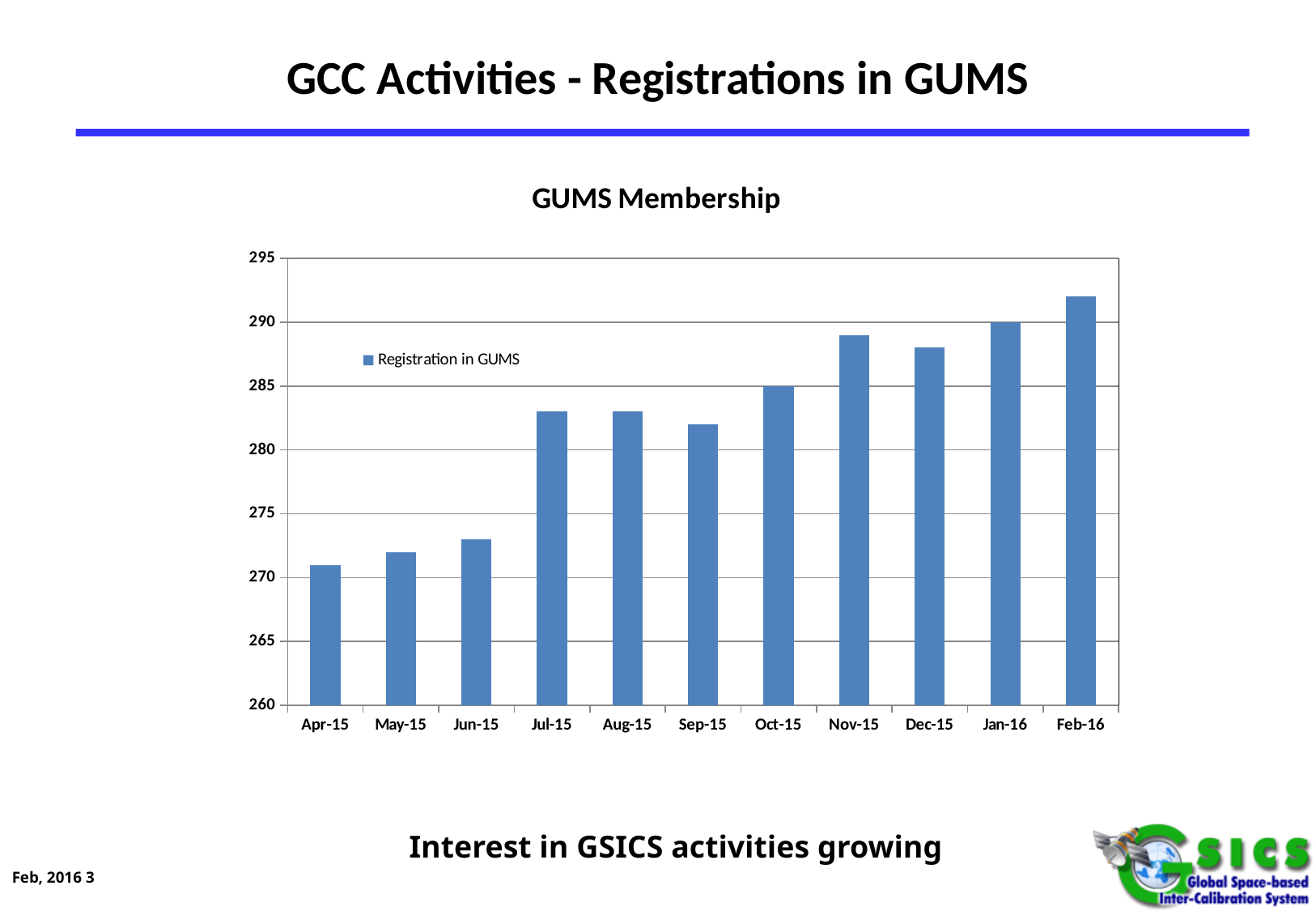
What type of chart is shown on the slide? Bar chart What is the value for Jan-16? 290 How many series does the legend list? 1 Is the value for Apr-15 greater or less than 275? less Which month has the highest number of registrations in GUMS? Feb-16 Is the value for Feb-16 greater or less than 290? greater How many months are shown on the x axis? 11 What is the value for Oct-15? 285 What is the title of the chart? GUMS Membership Which is larger, the value for Jun-15 or the value for Jul-15? Jul-15 Which month has the lowest number of registrations in GUMS? Apr-15 What is the name of the series shown in the legend? Registration in GUMS